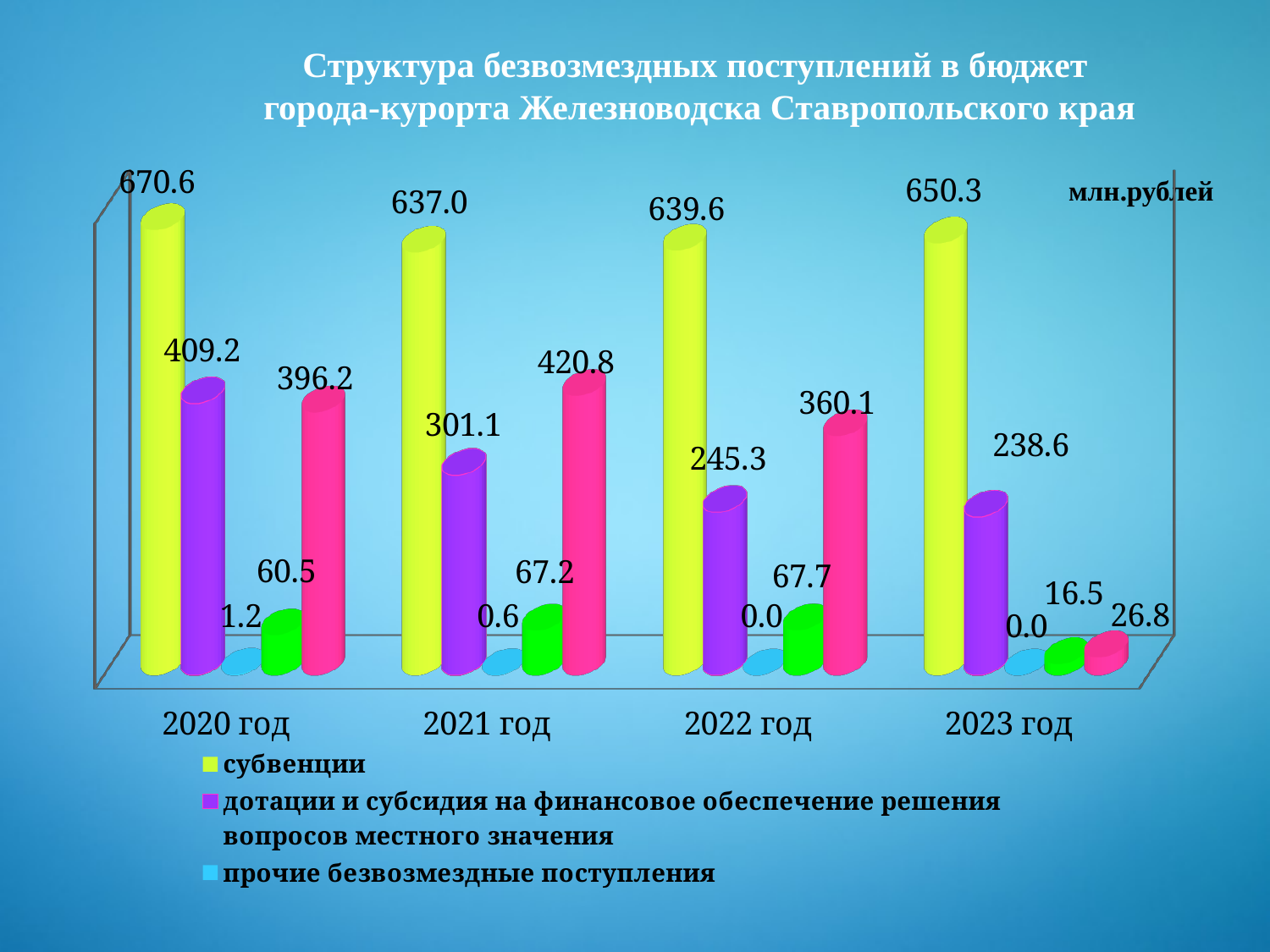
In which year is the value for субвенции the lowest? 2021 год What kind of chart is shown on the slide? bar chart In which year is the value for субвенции the highest? 2020 год How many series does the legend list? 3 What is the difference between the субвенции values for 2020 год and 2021 год? 33.6 Do the values for дотации и субсидия на финансовое обеспечение решения вопросов местного значения rise or fall from 2020 год to 2023 год? fall What is the value for дотации и субсидия на финансовое обеспечение решения вопросов местного значения in 2023 год? 238.6 Which year has the larger value for дотации и субсидия на финансовое обеспечение решения вопросов местного значения: 2020 год or 2021 год? 2020 год What is the value for прочие безвозмездные поступления in 2020 год? 1.2 What unit is indicated for the values on the chart? млн.рублей How many years are shown on the x axis? 4 What is the value for субвенции in 2020 год? 670.6